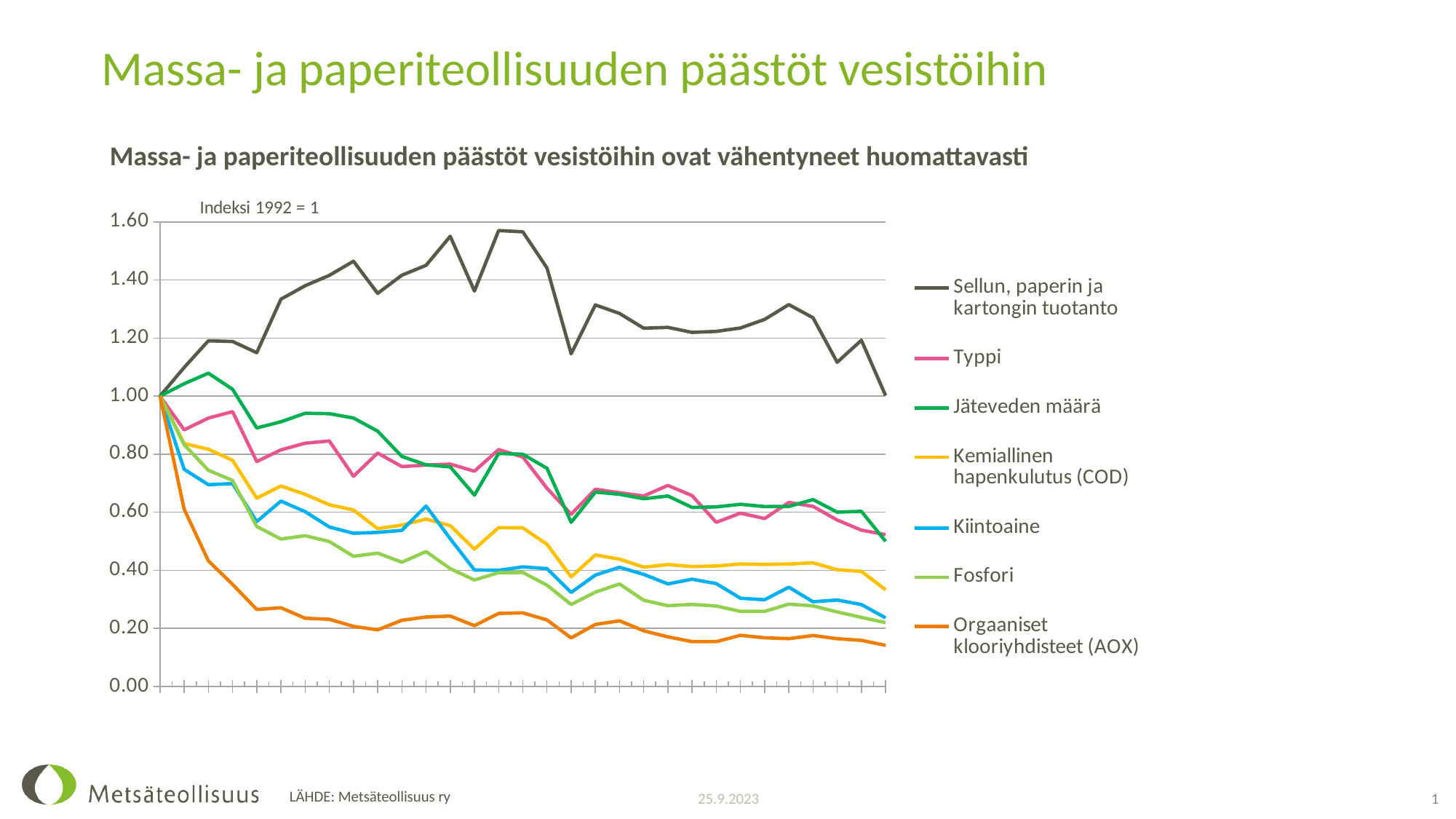
What kind of chart is shown on the slide? line chart What is the index base noted above the chart? Indeksi 1992 = 1 Which series reaches the highest value anywhere on the chart? Sellun, paperin ja kartongin tuotanto Which series has the highest value at the right end of the chart? Sellun, paperin ja kartongin tuotanto What is the value of every series at the first point on the x axis? 1.00 At the right end of the chart, which is larger: Kemiallinen hapenkulutus (COD) or Kiintoaine? Kemiallinen hapenkulutus (COD) How many series does the legend list? 7 Is the final value of Typpi greater or less than 0.60? less Is the final value of Orgaaniset klooriyhdisteet (AOX) greater or less than 0.20? less Does the Orgaaniset klooriyhdisteet (AOX) series rise or fall overall along the x axis? fall Which series has the lowest value at the right end of the chart? Orgaaniset klooriyhdisteet (AOX) Is the peak value of Sellun, paperin ja kartongin tuotanto greater or less than 1.40? greater